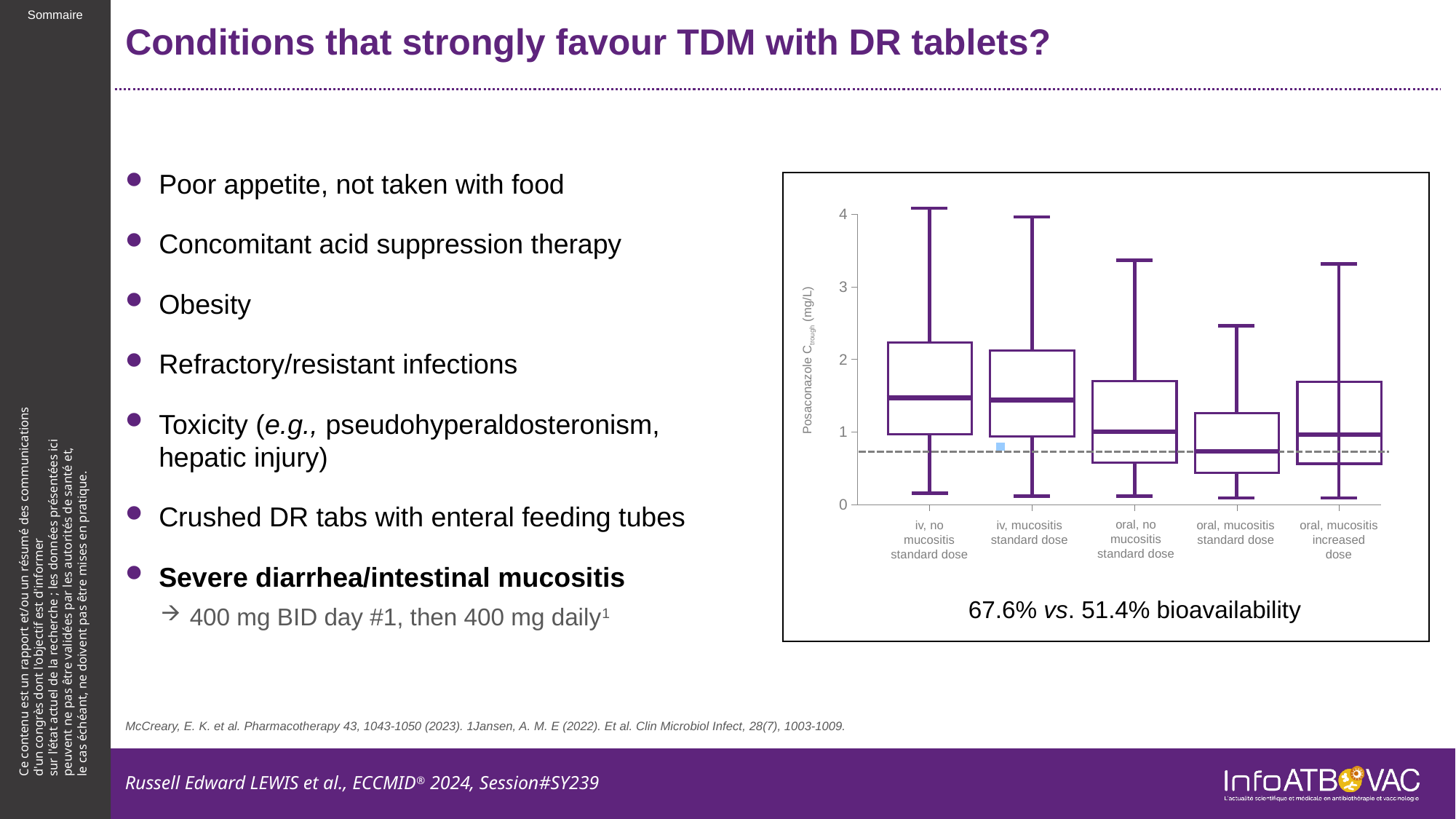
How many categories are shown on the x axis of the chart? 5 What is the label of the y axis of the chart? Posaconazole Ctrough (mg/L) Is the median value for 'iv, no mucositis standard dose' greater or less than 1? greater Is the median value for 'oral, mucositis standard dose' greater or less than 1? less Which category has the lowest median posaconazole Ctrough? oral, mucositis standard dose Is the top of the upper whisker for 'oral, mucositis standard dose' greater or less than 3? less What kind of chart is shown on the slide? box plot Which has the larger median posaconazole Ctrough: 'iv, no mucositis standard dose' or 'oral, mucositis standard dose'? iv, no mucositis standard dose What bioavailability comparison is printed below the chart? 67.6% vs. 51.4% bioavailability Which has the larger median posaconazole Ctrough: 'oral, mucositis increased dose' or 'oral, mucositis standard dose'? oral, mucositis increased dose